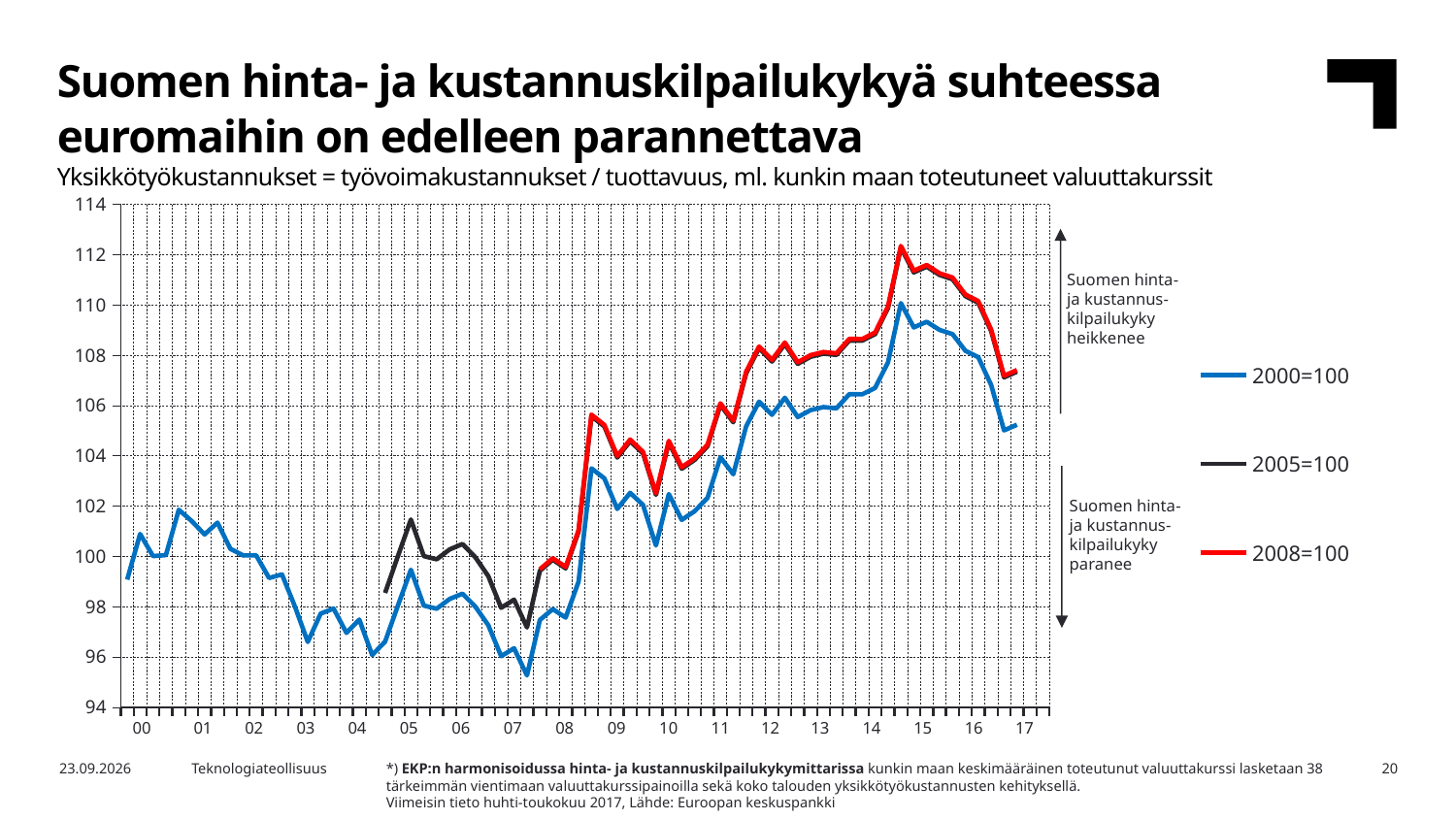
Does the 2008=100 series rise or fall between 2015 and 2017? fall In 2010, which series is higher, 2000=100 or 2008=100? 2008=100 Is the final value of the 2000=100 series in 2017 greater or less than 104? greater What are the three series named in the legend? 2000=100, 2005=100, 2008=100 How many series does the legend list? 3 How many year labels are shown on the x axis? 18 What colour is the 2008=100 series drawn in? red Does the 2000=100 series rise or fall between 2008 and 2014? rise Which series reaches the highest value on the chart? 2008=100 What kind of chart is shown on the slide? line chart Is the lowest value of the 2000=100 series (around 2007) greater or less than 96? less Is the highest value reached by the 2008=100 series (around 2014–15) greater or less than 110? greater